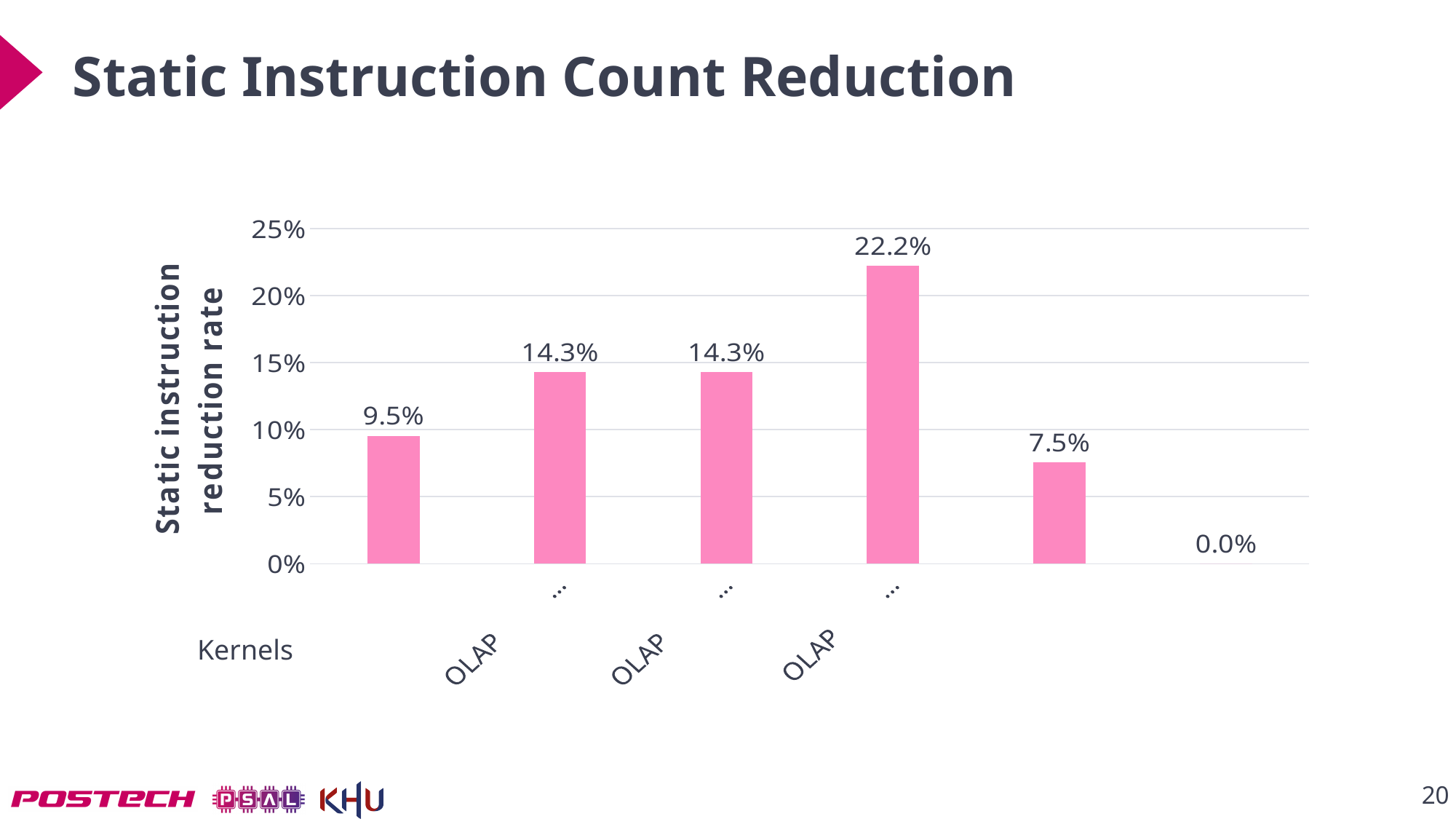
Which category has the lowest static instruction reduction rate? the last (rightmost) category (0.0%) What is the value of the fifth bar from the left in the chart? 7.5% What is the value of the fourth bar from the left in the chart? 22.2% How many bars (categories) are plotted in the chart? 6 Which is larger: the value of the second bar or the value of the fifth bar? the second bar (14.3%) What kind of chart is shown on the slide? bar chart Which bar has the highest static instruction reduction rate? the fourth bar (22.2%) What is the difference between the highest value (22.2%) and the first bar's value (9.5%)? 12.7% What is the value shown for the last (rightmost) category in the chart? 0.0% What is the label of the y-axis in the chart? Static instruction reduction rate What is the value of the first (leftmost) bar in the chart? 9.5% Is the value of the fourth bar greater or less than 20%? greater